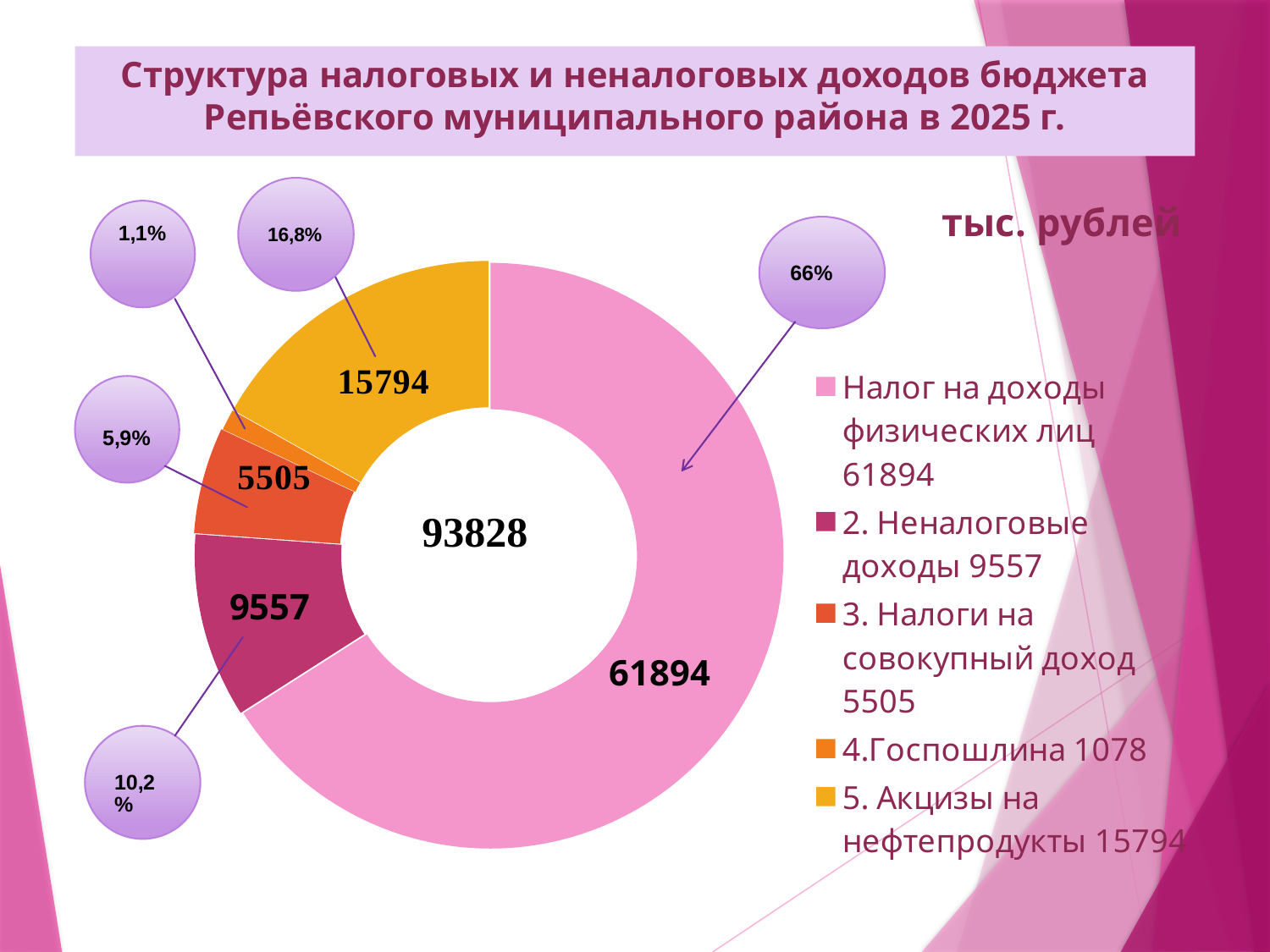
What is the value for Госпошлина? 1078 What share of the chart does Акцизы на нефтепродукты represent? 16,8% What is the value for Акцизы на нефтепродукты? 15794 Which category has the largest share of the chart? Налог на доходы физических лиц Which category has the smallest share of the chart? Госпошлина What is the value for Налог на доходы физических лиц? 61894 What is the difference between the values for Акцизы на нефтепродукты and Неналоговые доходы? 6237 Which is larger: Неналоговые доходы or Налоги на совокупный доход? Неналоговые доходы What is the value for Неналоговые доходы? 9557 What kind of chart is shown on the slide? doughnut (pie) chart How many categories does the legend list? 5 What share of the chart does Налоги на совокупный доход represent? 5,9%